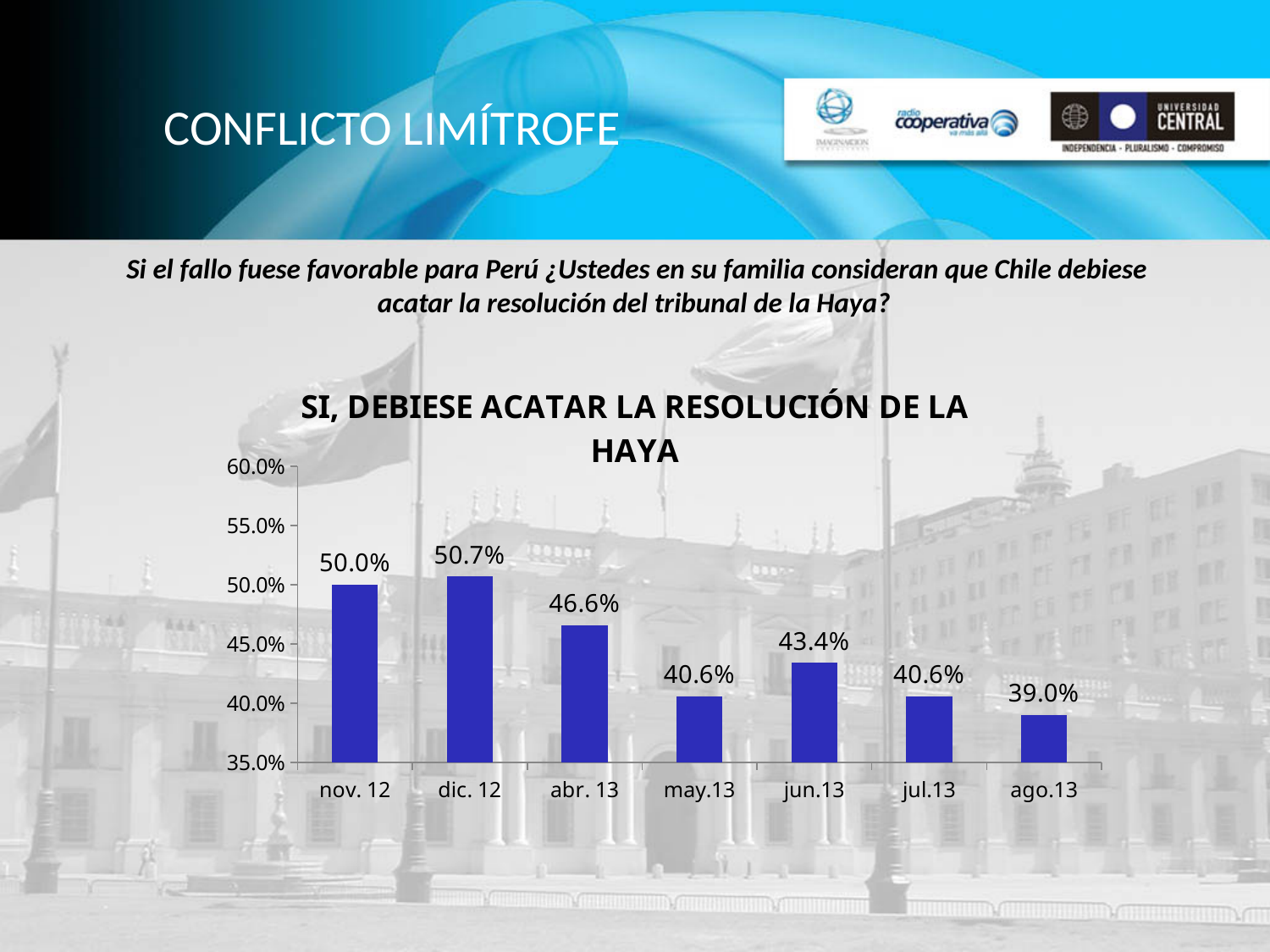
Is the value for may.13 greater or less than 45.0%? less What is the value for jun.13? 43.4% Which is larger, the value for abr. 13 or the value for jun.13? abr. 13 What is the difference between the values for nov. 12 and ago.13? 11.0% What is the title of the chart? SI, DEBIESE ACATAR LA RESOLUCIÓN DE LA HAYA Do the values generally rise or fall from dic. 12 to ago.13? fall What is the value for ago.13? 39.0% What is the value for dic. 12? 50.7% What kind of chart is shown on the slide? bar chart Which category has the lowest value? ago.13 Which category has the highest value? dic. 12 How many categories are shown on the x axis? 7